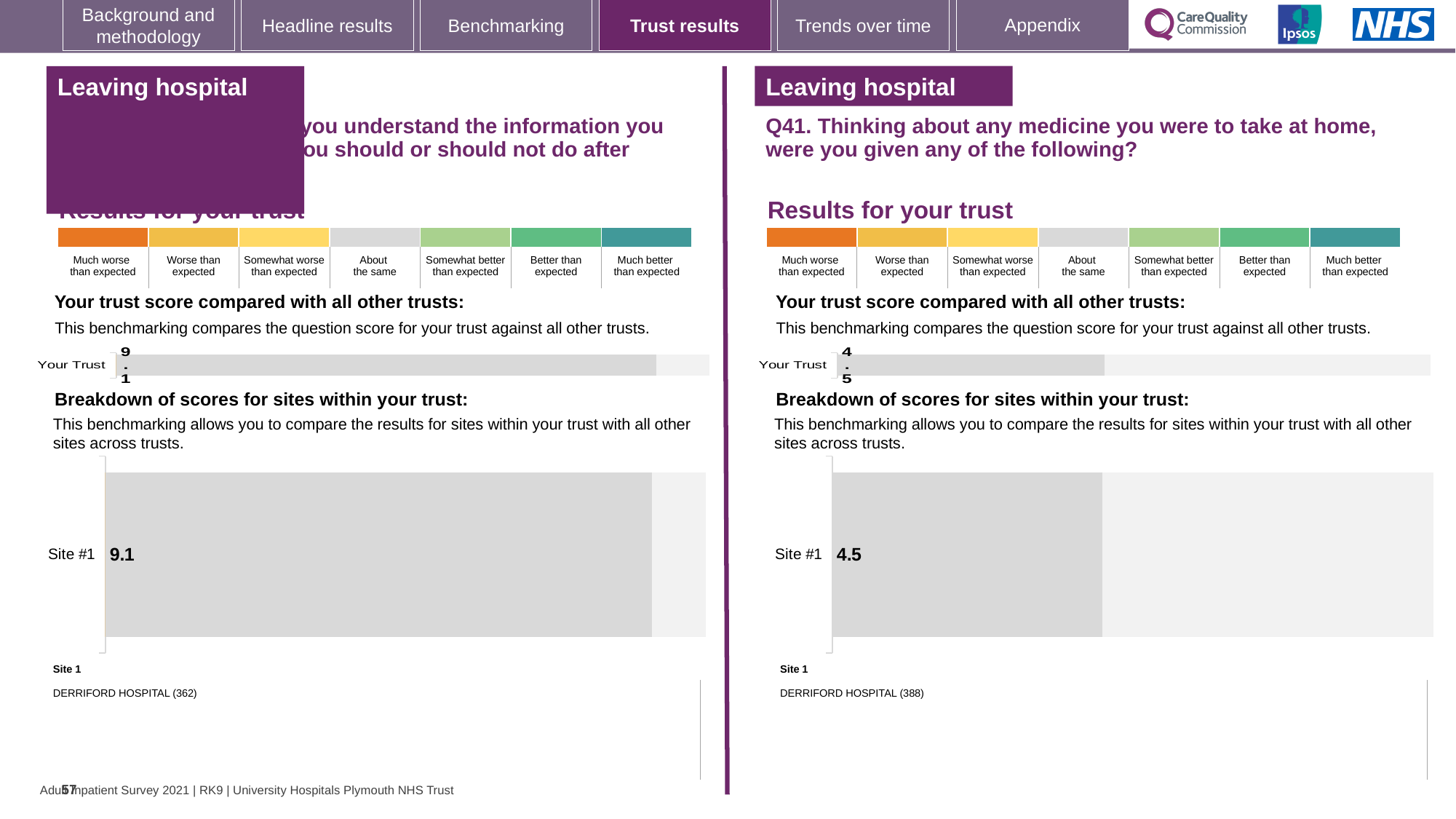
How many sites are plotted in the right-hand (Q41) breakdown of scores for sites chart? 1 How many sites are plotted in the left-hand breakdown of scores for sites chart? 1 Which site is listed as Site 1 beneath the left-hand breakdown chart? DERRIFORD HOSPITAL (362) On the right half of the slide (Q41), what is the value shown for Your Trust in the trust score bar chart? 4.5 On the left half of the slide, what is the value shown for Your Trust in the trust score bar chart? 9.1 What kind of chart is used to show the Site #1 score on the right half of the slide? bar chart In the left-hand breakdown of scores for sites chart, what is the value for Site #1? 9.1 Which is larger: the Site #1 value in the left-hand chart or the Site #1 value in the right-hand (Q41) chart? the left-hand chart In the right-hand (Q41) breakdown of scores for sites chart, what is the value for Site #1? 4.5 Which site is listed as Site 1 beneath the right-hand (Q41) breakdown chart? DERRIFORD HOSPITAL (388) What is the difference between the Site #1 value in the left-hand chart and the Site #1 value in the right-hand (Q41) chart? 4.6 Is the Your Trust value in the right-hand (Q41) chart greater or less than the Your Trust value in the left-hand chart? less